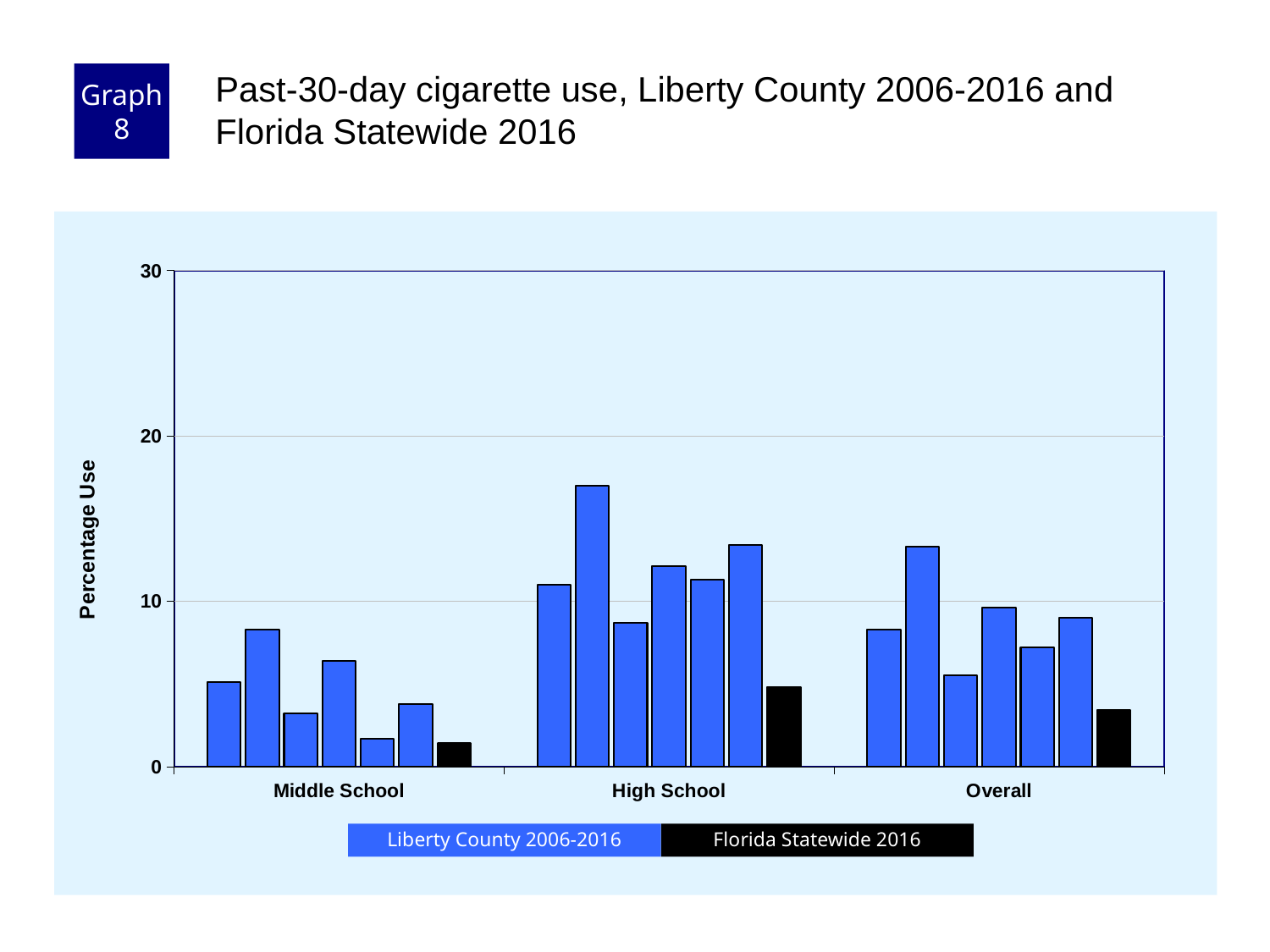
How many series does the legend list? 2 Is the tallest Liberty County bar for High School greater or less than 10? greater Is the tallest Liberty County bar for Middle School greater or less than 10? less What kind of chart is shown on the slide? bar chart Is the Florida Statewide 2016 value for High School greater or less than 10? less What is the label on the y axis? Percentage Use Which category has the lowest Florida Statewide 2016 value? Middle School Which is larger, the Florida Statewide 2016 value for High School or for Middle School? High School Which colour represents Florida Statewide 2016 in the legend? black Which category contains the tallest bar on the chart? High School How many categories are shown on the x axis? 3